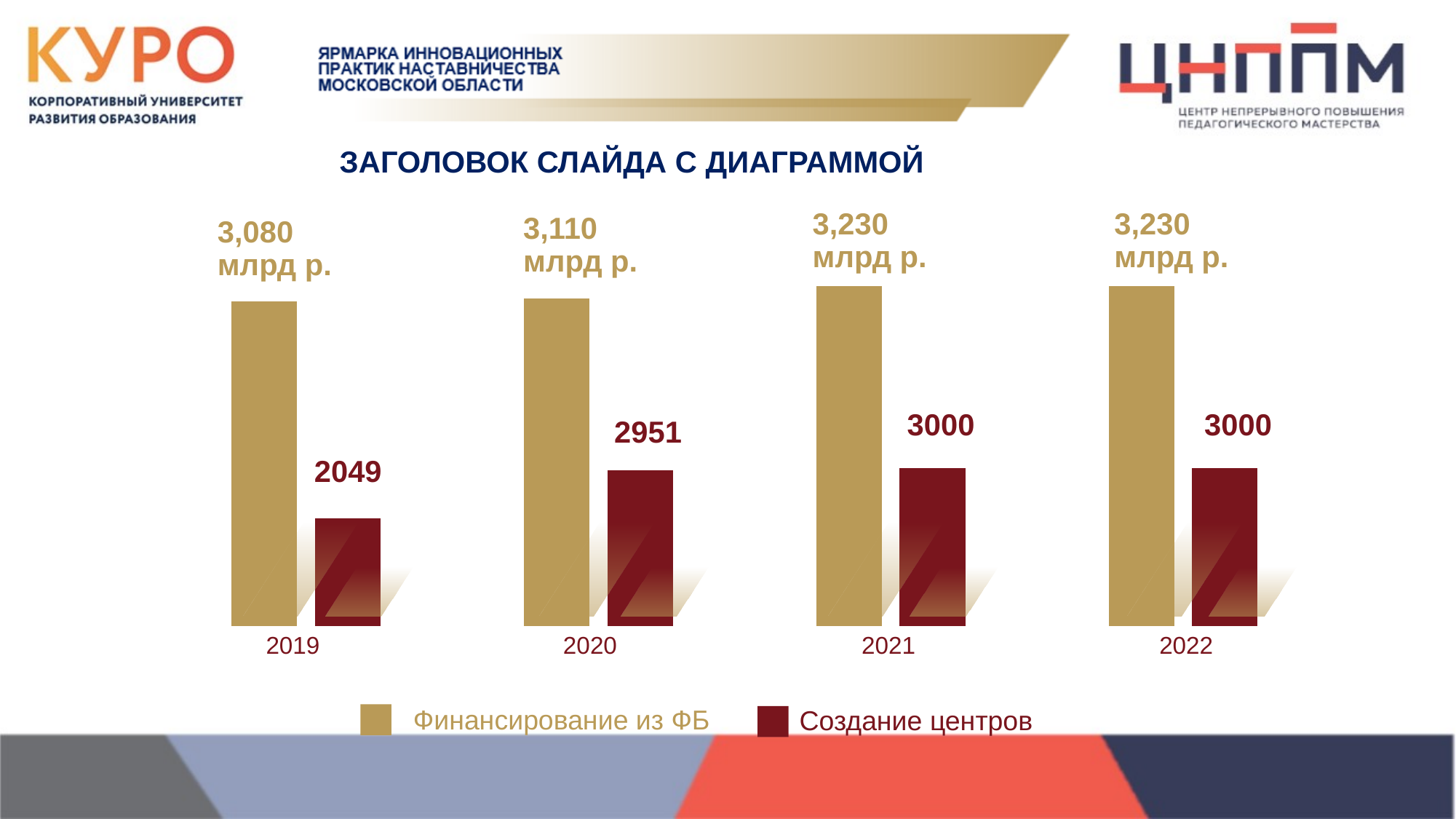
What is the value of Создание центров for 2020? 2951 What is the value of Финансирование из ФБ for 2019? 3,080 млрд р. What type of chart is shown on the slide? bar chart Does the value of Создание центров rise or fall from 2019 to 2021? rise How many series does the legend list? 2 What is the difference between the Создание центров values for 2020 and 2019? 902 In which year is the value of Финансирование из ФБ lowest? 2019 What is the value of Создание центров for 2019? 2049 How many years are shown on the x axis? 4 Which is larger for 2020: the Создание центров value or the Создание центров value for 2019? 2020 What is the value of Финансирование из ФБ for 2021? 3,230 млрд р. In which year is the value of Создание центров lowest? 2019